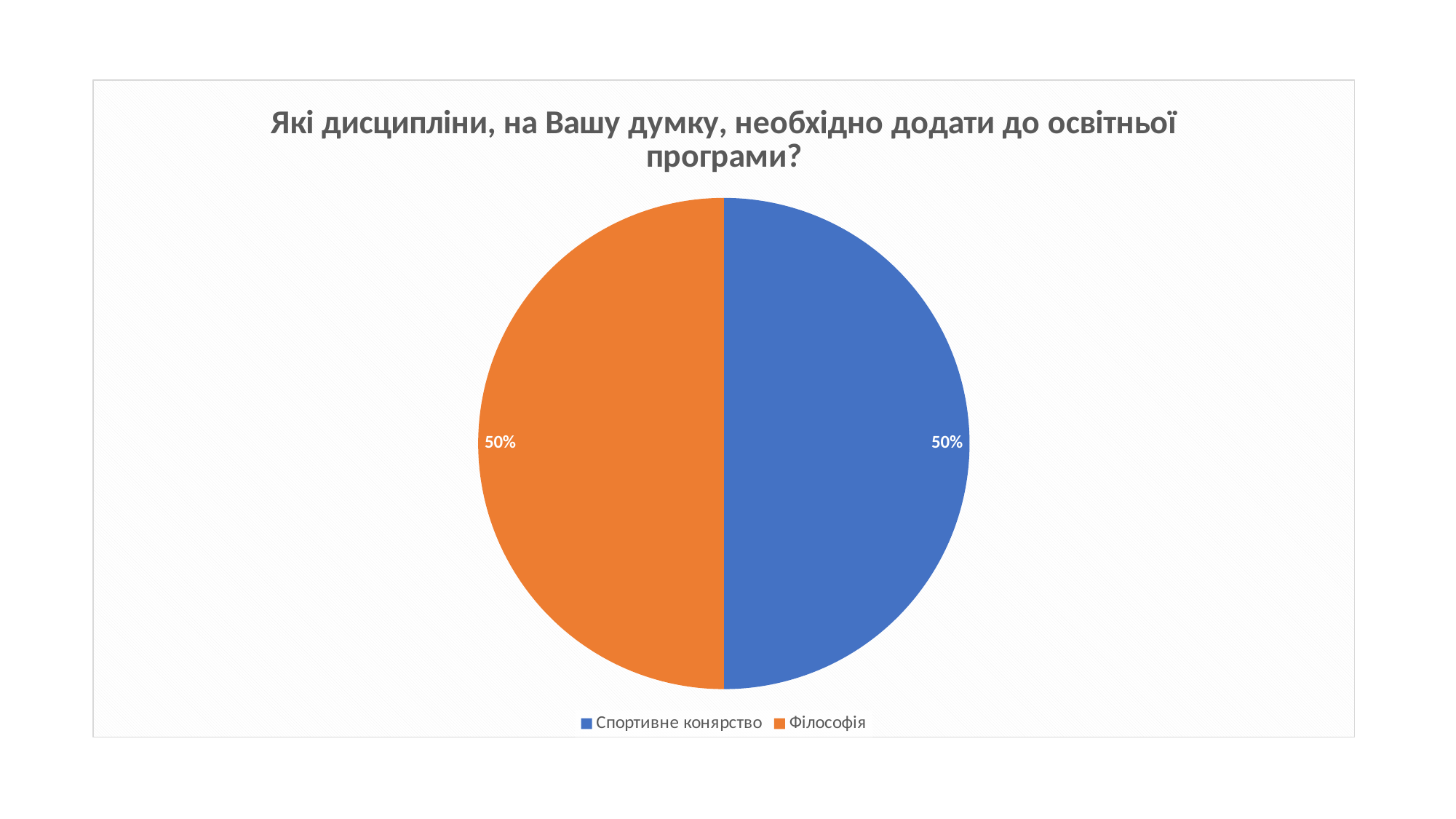
What share of the pie does Філософія have? 50% How many slices does the pie chart have? 2 Is the share for Спортивне конярство greater or less than 25%? greater What share of the pie does Спортивне конярство have? 50% What kind of chart is shown on the slide? pie chart What is the title of the chart? Які дисципліни, на Вашу думку, необхідно додати до освітньої програми? What is the difference between the shares of Спортивне конярство and Філософія? 0% Is the share for Філософія greater or less than 75%? less How many entries does the legend list? 2 What is the total of the two slices shown in the pie chart? 100% Which colour represents Філософія in the pie chart? orange